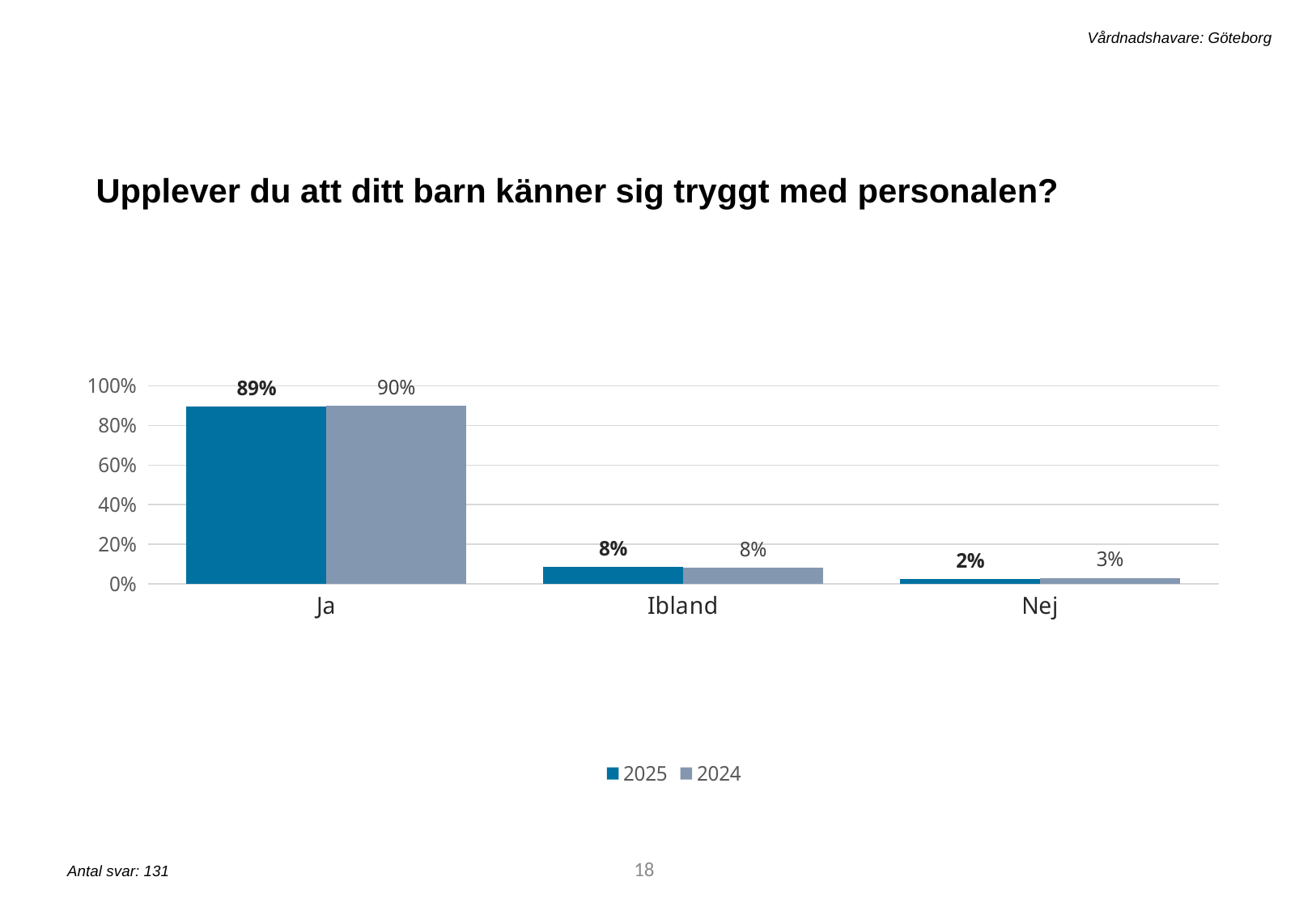
How many categories are shown on the x axis? 3 What is the difference between the 2024 and 2025 values for Ja? 1% Which is larger for Nej: the 2025 value or the 2024 value? 2024 Is the value for Ja in 2025 greater or less than 80%? greater Which category has the highest value in the 2025 series? Ja What is the value for Ibland in the 2025 series? 8% How many series does the legend list? 2 What is the value for Ja in the 2025 series? 89% What kind of chart is shown on the slide? Bar chart What is the value for Nej in the 2024 series? 3% Which category has the lowest value in the 2024 series? Nej What is the value for Ja in the 2024 series? 90%